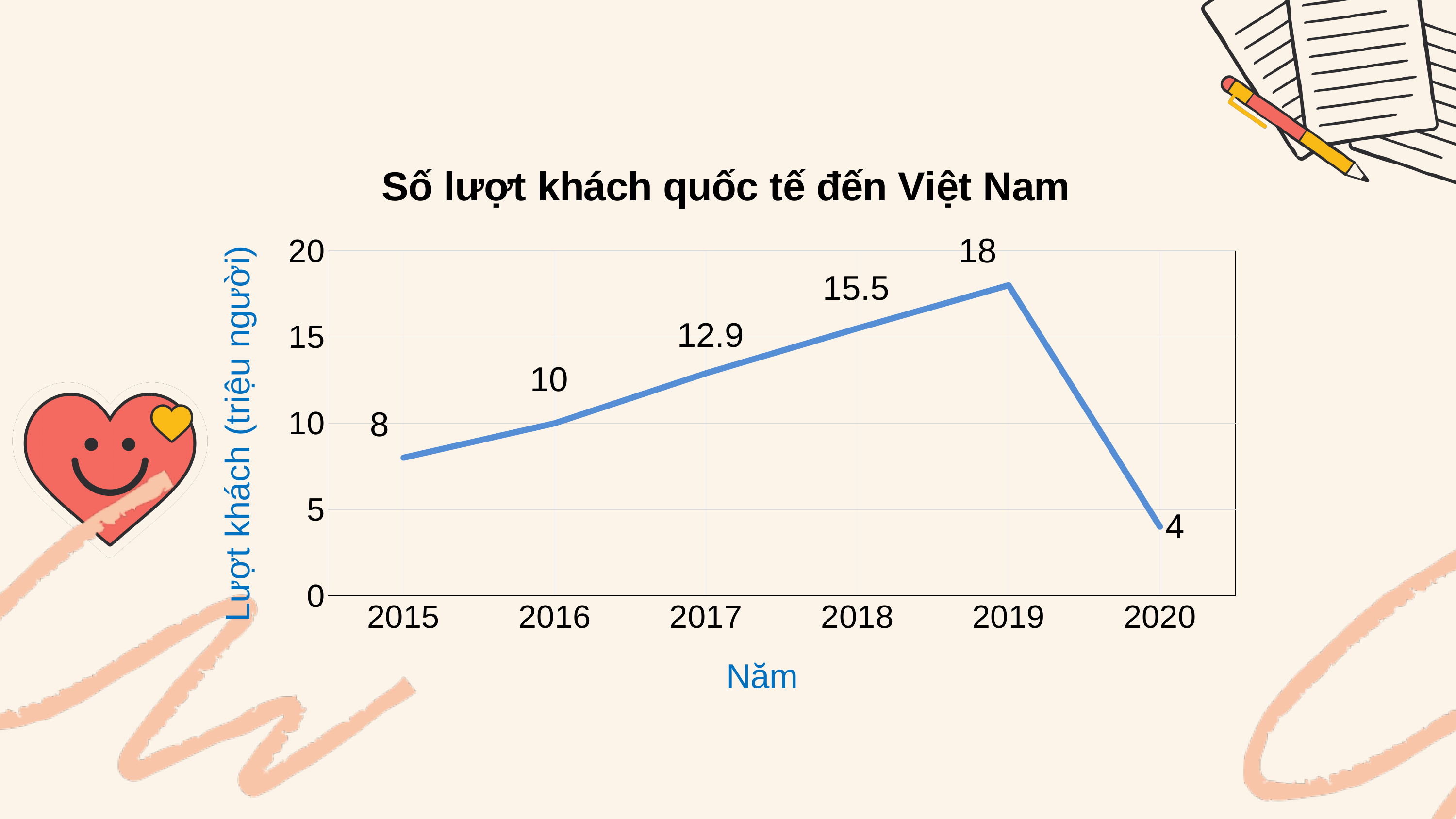
Which year has the lowest value? 2020 Do the values rise or fall from 2015 to 2019? rise Which year has the highest value? 2019 What is the difference between the values for 2018 and 2017? 2.6 What is the value for 2019? 18 How many years are plotted on the chart? 6 What is the value for 2020? 4 What is the difference between the values for 2019 and 2020? 14 Which is larger, the value for 2016 or the value for 2018? 2018 What is the value for 2017? 12.9 Is the value for 2018 greater or less than 15? greater What kind of chart is shown? line chart